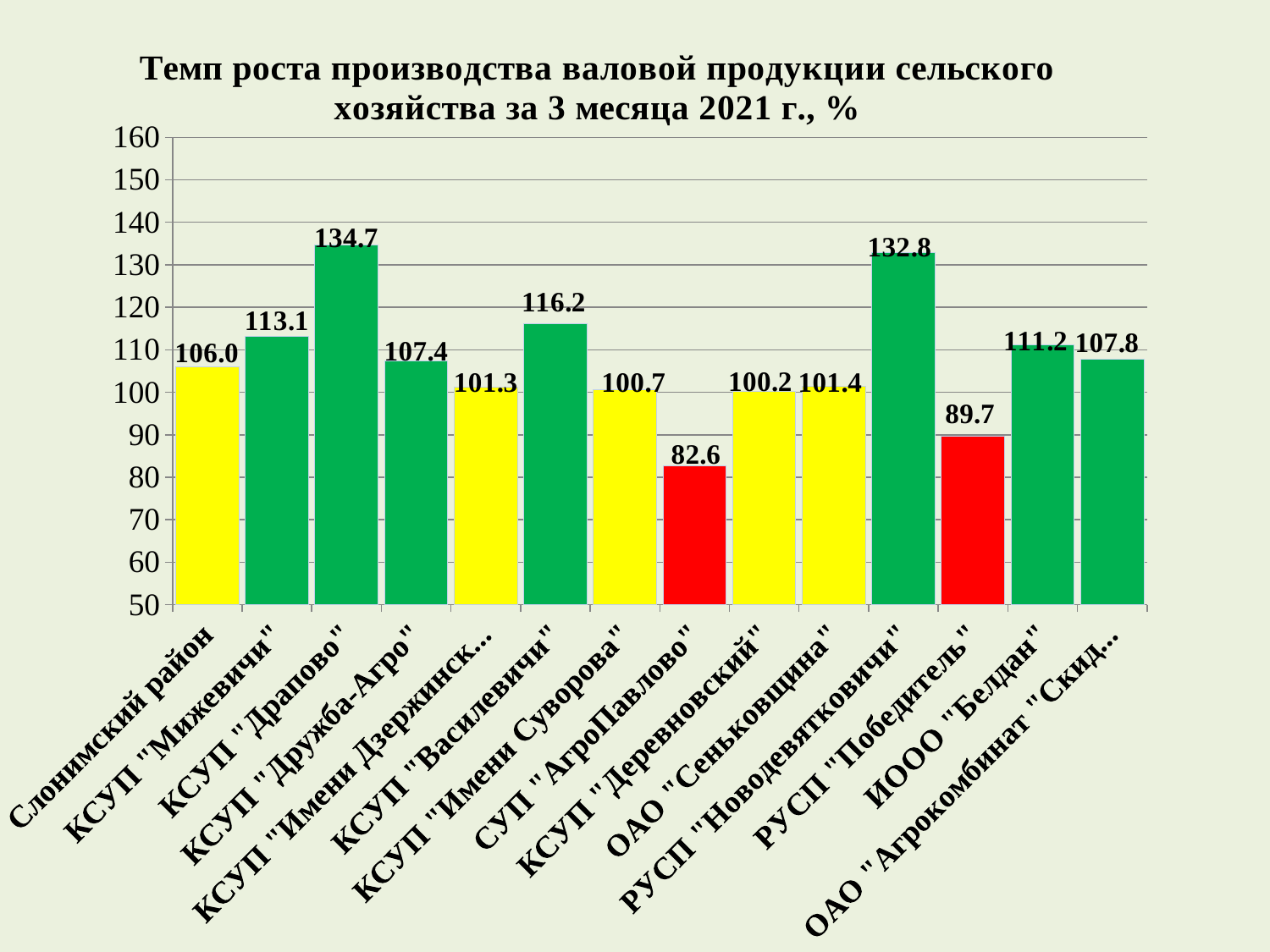
What colour are the bars for СУП "АгроПавлово" and РУСП "Победитель"? red What is the difference between the values for КСУП "Драпово" and РУСП "Новодевятковичи"? 1.9 What is the value for КСУП "Драпово"? 134.7 What is the difference between the values for ИООО "Белдан" and РУСП "Победитель"? 21.5 Which is larger, the value for КСУП "Мижевичи" or the value for ИООО "Белдан"? КСУП "Мижевичи" Is the value for КСУП "Василевичи" greater or less than 110? greater What is the value for Слонимский район? 106.0 Which category has the lowest value? СУП "АгроПавлово" What is the value for РУСП "Победитель"? 89.7 What kind of chart is shown on the slide? bar chart Which category has the highest value? КСУП "Драпово" How many categories are shown on the x axis? 14